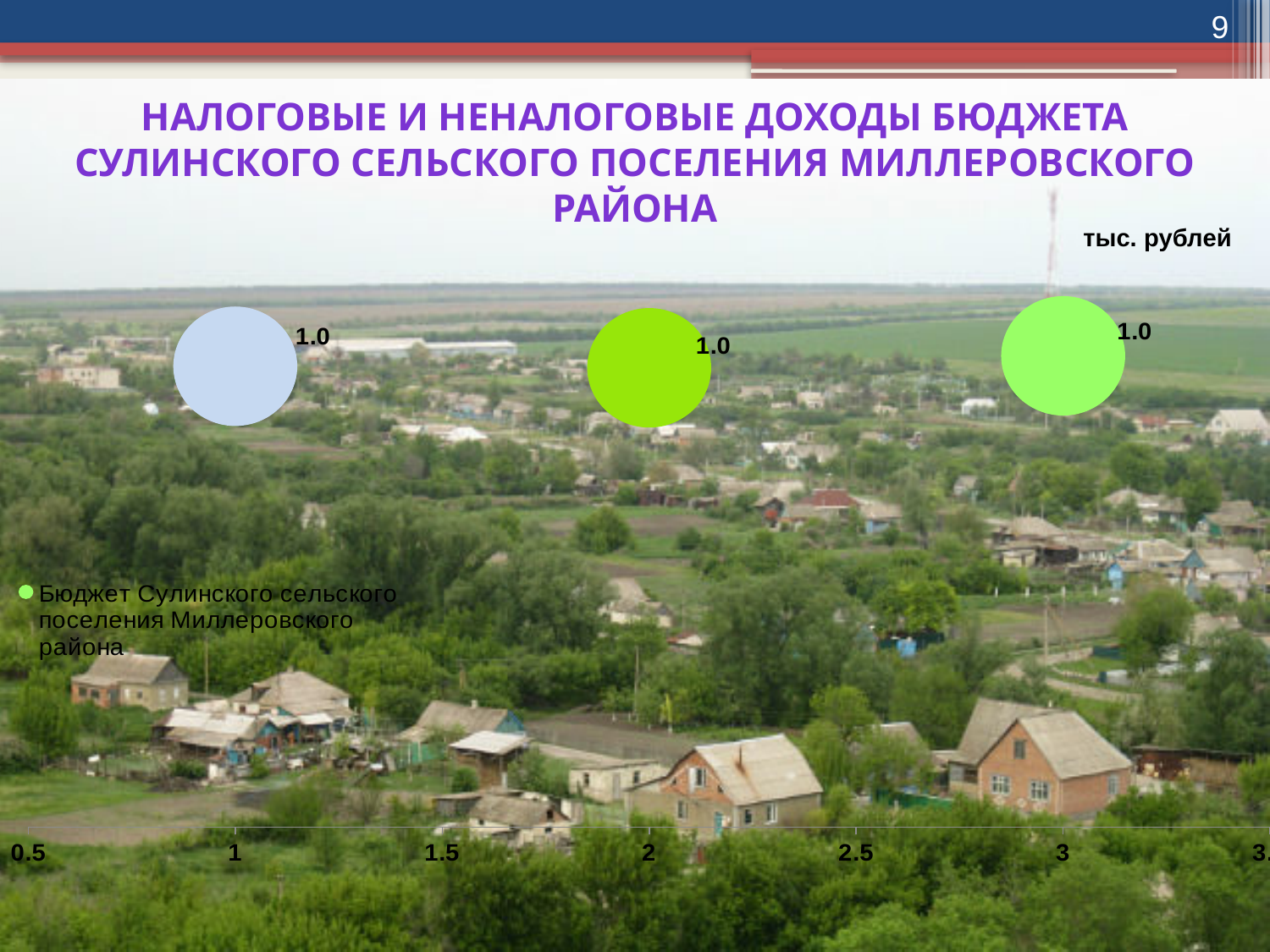
How many bubbles are plotted on the chart? 3 How many series does the legend list? 1 What is the data label on the leftmost bubble? 1.0 What is the legend entry of the chart? Бюджет Сулинского сельского поселения Миллеровского района What is the data label on the rightmost bubble? 1.0 Is the data label of the leftmost bubble larger than, smaller than, or equal to that of the rightmost bubble? equal What kind of chart is shown on the slide? bubble chart What unit is stated above the chart? тыс. рублей Do the bubble data labels rise, fall, or stay the same from left to right along the x axis? stay the same What is the difference between the data labels of the middle and the leftmost bubbles? 0.0 What is the data label on the middle bubble? 1.0